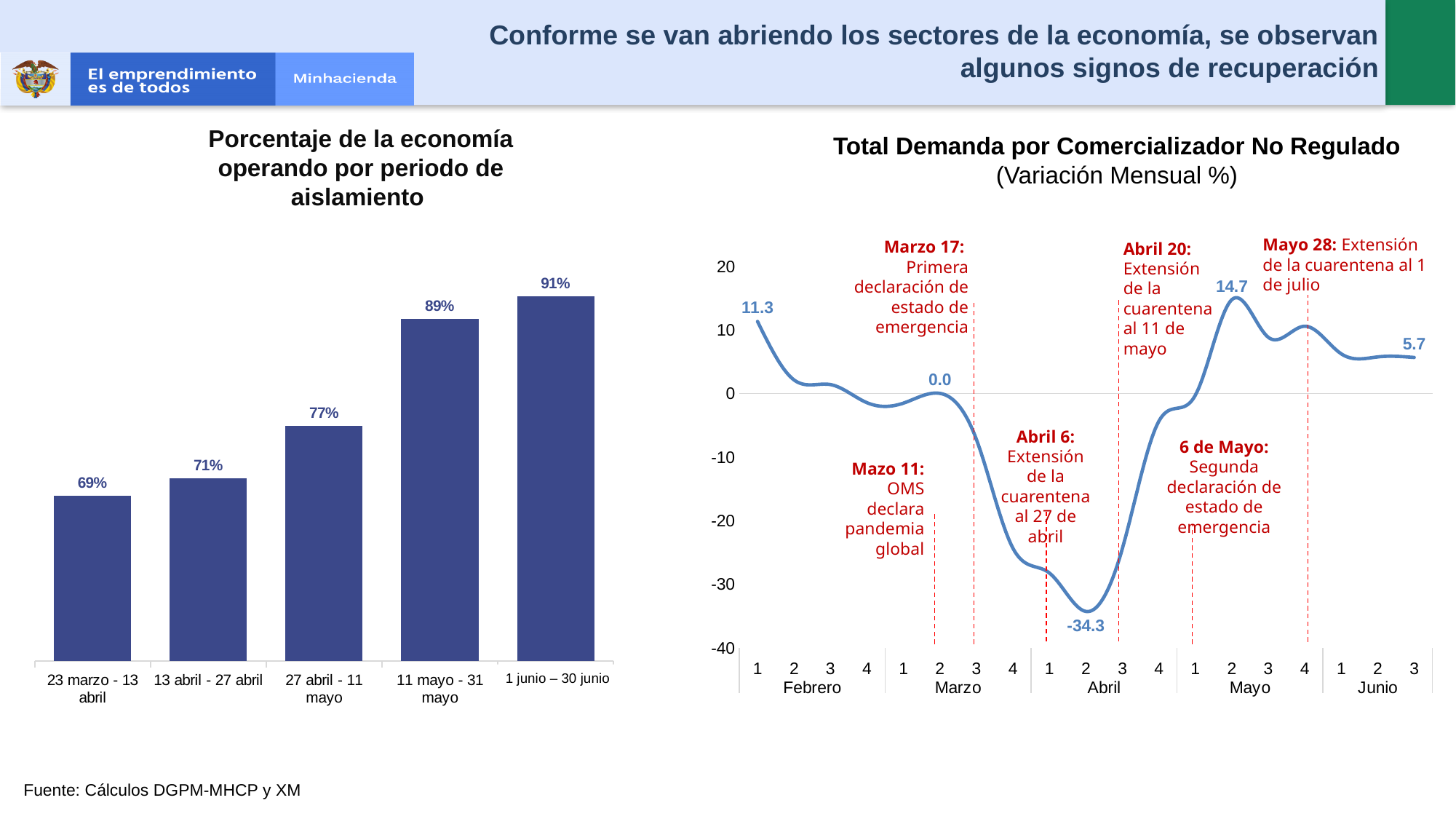
What kind of chart is 'Porcentaje de la economía operando por periodo de aislamiento'? bar chart In the chart 'Total Demanda por Comercializador No Regulado', what is the labelled value at the end of the series in Junio? 5.7 In the chart 'Porcentaje de la economía operando por periodo de aislamiento', which period has the highest value? 1 junio – 30 junio In the chart 'Total Demanda por Comercializador No Regulado', what is the lowest labelled value? -34.3 In the chart 'Porcentaje de la economía operando por periodo de aislamiento', what is the value for '27 abril - 11 mayo'? 77% In the chart 'Total Demanda por Comercializador No Regulado', what is the labelled value at the start of the series in Febrero? 11.3 In the chart 'Porcentaje de la economía operando por periodo de aislamiento', which period has the lowest value? 23 marzo - 13 abril In the chart 'Porcentaje de la economía operando por periodo de aislamiento', what is the difference between the values for '11 mayo - 31 mayo' and '13 abril - 27 abril'? 18 percentage points What kind of chart is 'Total Demanda por Comercializador No Regulado'? line chart In the chart 'Total Demanda por Comercializador No Regulado', which is larger: the labelled peak in Mayo (14.7) or the starting value in Febrero (11.3)? 14.7 In the chart 'Porcentaje de la economía operando por periodo de aislamiento', do the values rise or fall from left to right? rise In the chart 'Porcentaje de la economía operando por periodo de aislamiento', how many periods are shown? 5